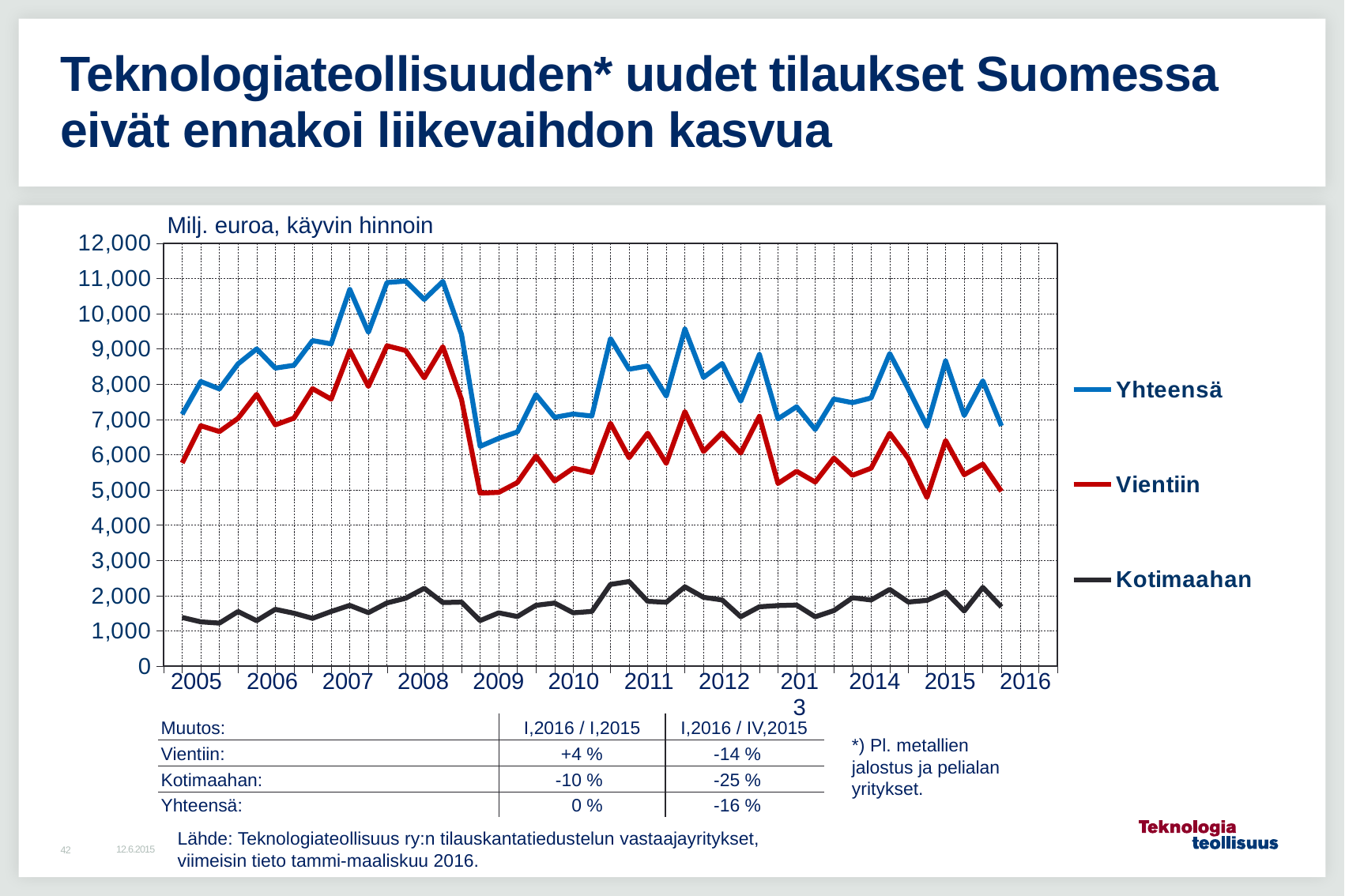
Is the peak value of Yhteensä around 2008 greater or less than 10,000? greater What unit label is shown above the chart's y axis? Milj. euroa, käyvin hinnoin Which series has the lowest values throughout the chart? Kotimaahan How many year labels are shown on the x axis? 12 How many series does the legend list? 3 Is the value for Kotimaahan at the start of 2005 greater or less than 3,000? less Is the value for Vientiin at the start of 2009 greater or less than 6,000? less Which series has the highest values throughout the chart? Yhteensä Which series are listed in the legend? Yhteensä, Vientiin, Kotimaahan Does the Yhteensä series rise or fall between 2005 and 2008? rise What kind of chart is shown on the slide? line chart Which series is larger in 2010, Vientiin or Kotimaahan? Vientiin